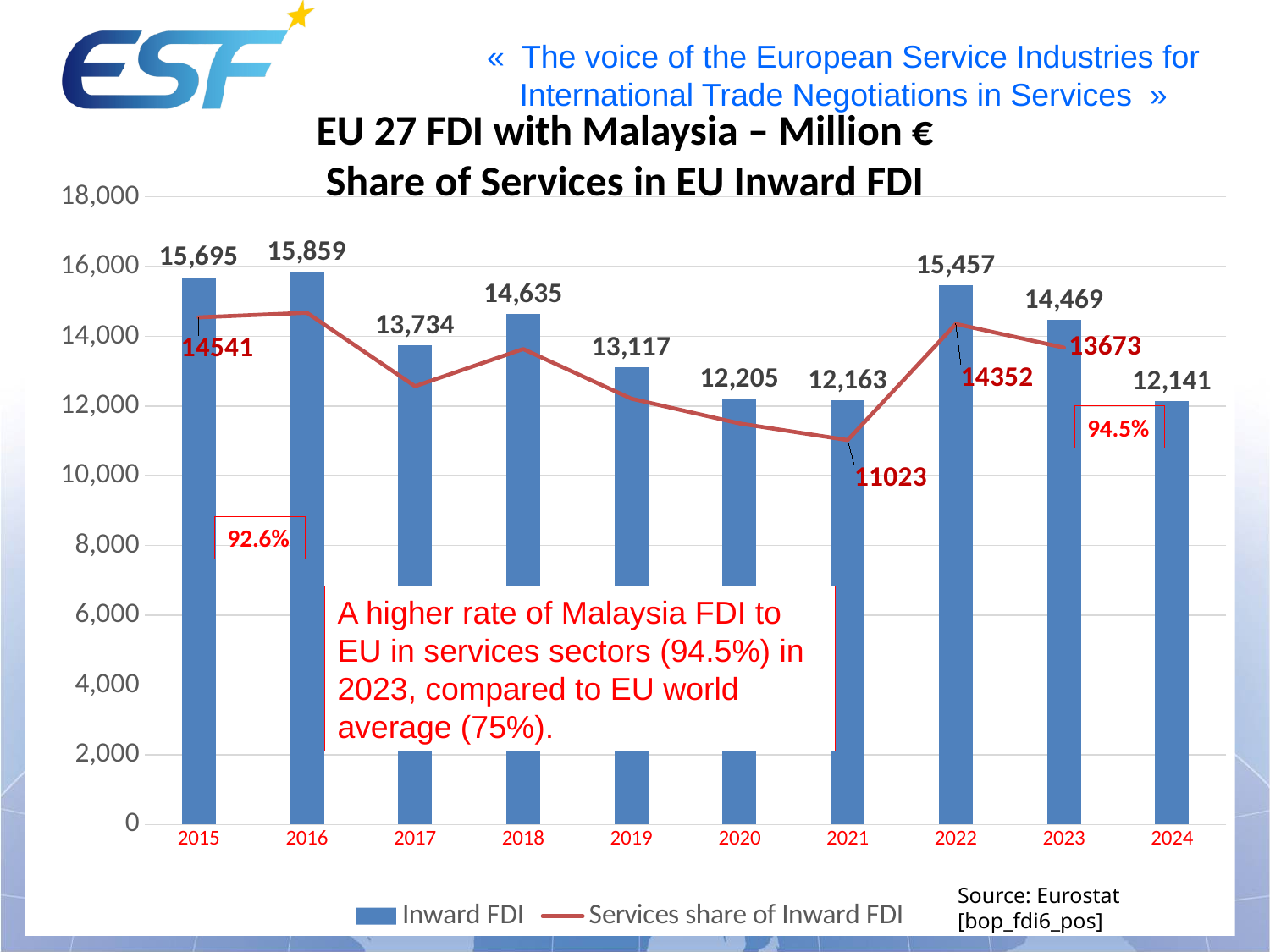
What is the source cited for the chart? Eurostat [bop_fdi6_pos] What is the Services share of Inward FDI value labelled for 2023? 13673 What is the Inward FDI value for 2024? 12,141 Which year has the highest Inward FDI? 2016 Which is larger, Inward FDI in 2018 or in 2019? 2018 Which year has the lowest Inward FDI? 2024 How many series does the legend list? 2 What is the difference between Inward FDI in 2022 and 2023? 988 What is the Services share of Inward FDI value labelled for 2021? 11023 Is the Services share of Inward FDI value for 2017 greater or less than 14,000? less What is the Inward FDI value for 2016? 15,859 How many years are shown on the x axis? 10